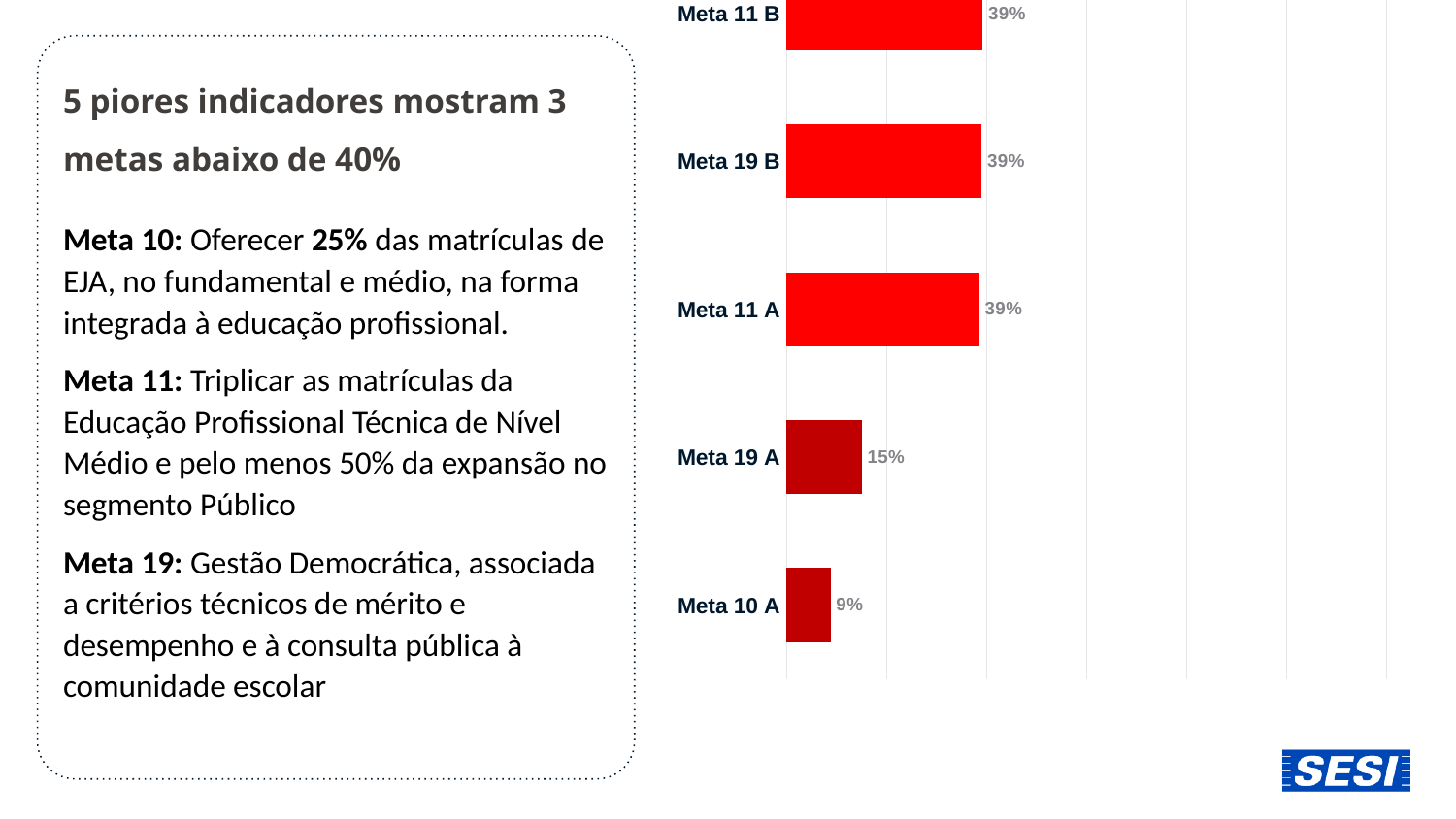
What is the value for Meta 11 A? 39% What is the difference between the value for Meta 19 A and the value for Meta 10 A? 6 percentage points What is the difference between the value for Meta 11 A and the value for Meta 19 A? 24 percentage points Which is larger, the value for Meta 19 A or the value for Meta 10 A? Meta 19 A What is the value for Meta 10 A? 9% What is the value for Meta 19 A? 15% What is the value for Meta 19 B? 39% What is the value for Meta 11 B? 39% How many categories are shown in the chart? 5 Which is larger, the value for Meta 11 A or the value for Meta 19 A? Meta 11 A What kind of chart is shown on the slide? Bar chart Which category has the lowest value? Meta 10 A